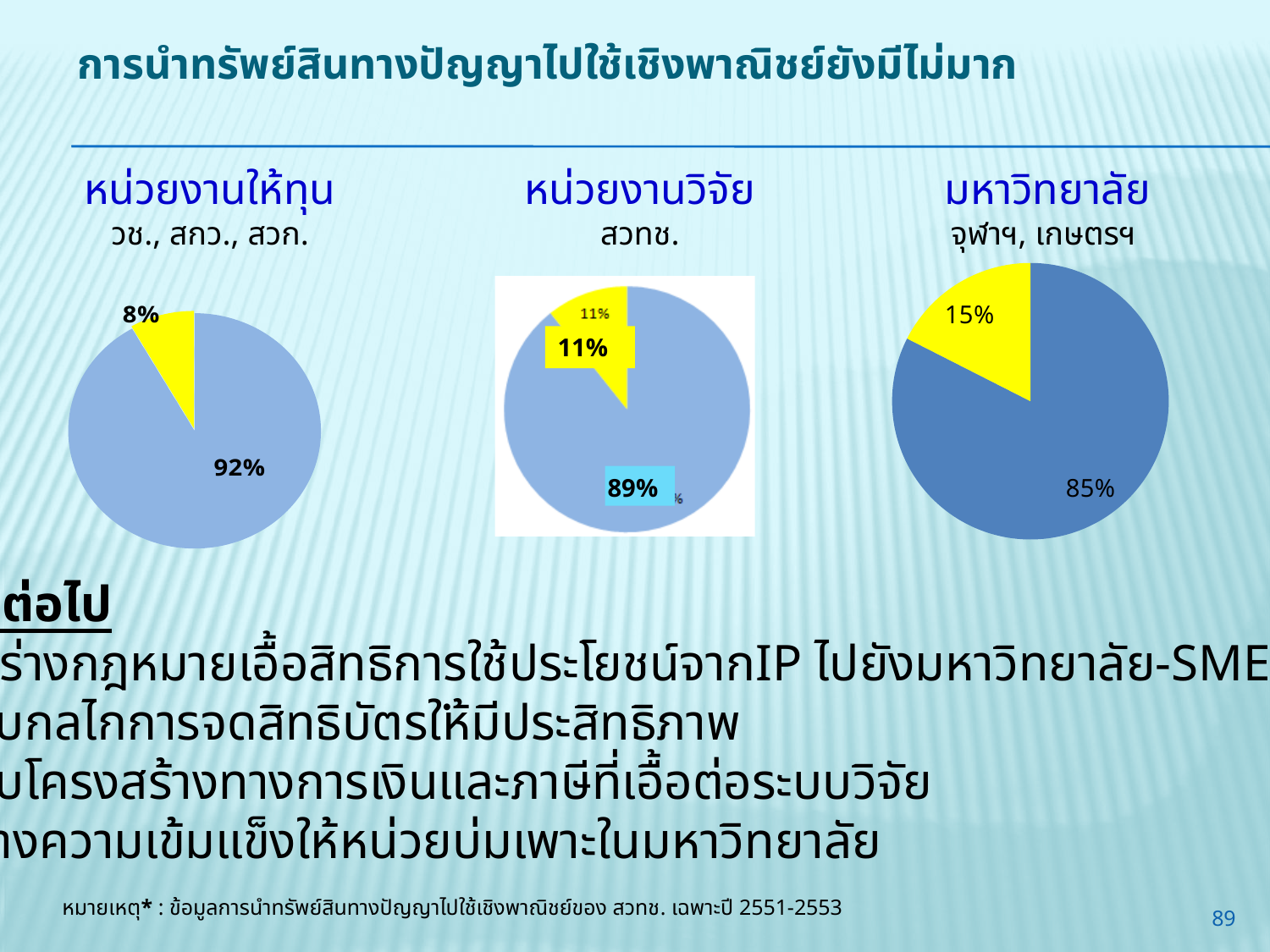
In the right pie chart (มหาวิทยาลัย), what percentage does the yellow slice show? 15% Which of the three pie charts has the smallest yellow slice? หน่วยงานให้ทุน In the left pie chart (หน่วยงานให้ทุน), what percentage does the blue slice show? 92% In the right pie chart (มหาวิทยาลัย), what percentage does the blue slice show? 85% In the middle pie chart (หน่วยงานวิจัย), what percentage does the yellow slice show? 11% How many slices does the right pie chart (มหาวิทยาลัย) have? 2 In the left pie chart (หน่วยงานให้ทุน), what percentage does the yellow slice show? 8% Which of the three pie charts has the largest yellow slice? มหาวิทยาลัย In the middle pie chart (หน่วยงานวิจัย), what percentage does the blue slice show? 89% What kind of chart is used for the หน่วยงานให้ทุน (left) chart? pie chart How many pie charts are shown on the slide? 3 What is the difference between the yellow slice in the right pie chart (มหาวิทยาลัย) and the yellow slice in the left pie chart (หน่วยงานให้ทุน)? 7%